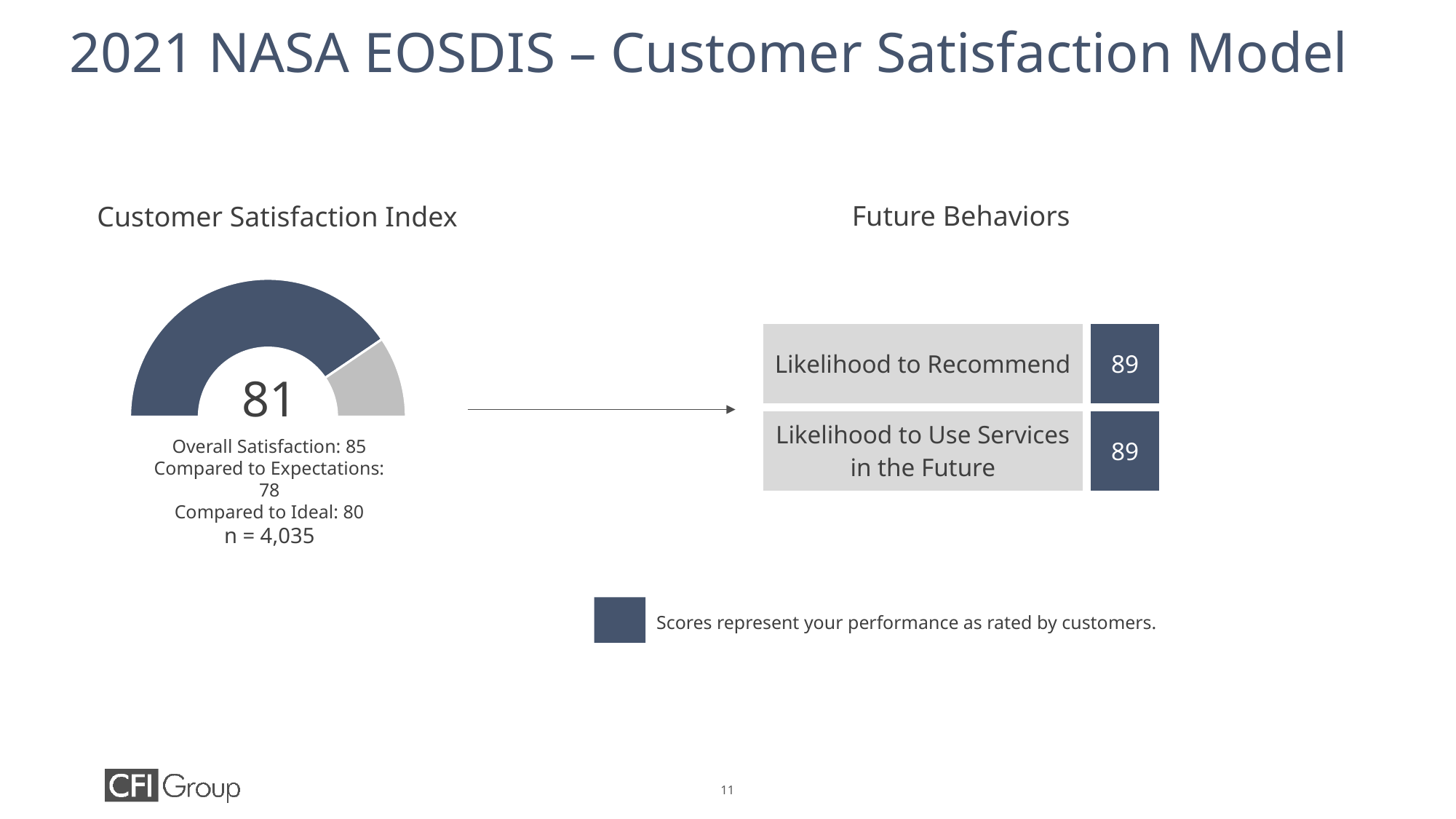
In the Future Behaviors section, what is the score for Likelihood to Recommend? 89 What is the Compared to Ideal score listed under the Customer Satisfaction Index gauge? 80 What kind of chart is used to display the Customer Satisfaction Index? gauge chart What sample size (n) is shown under the Customer Satisfaction Index gauge? 4,035 What is the Overall Satisfaction score listed under the Customer Satisfaction Index gauge? 85 What is the Compared to Expectations score listed under the Customer Satisfaction Index gauge? 78 Which of the three component scores under the Customer Satisfaction Index gauge is the highest? Overall Satisfaction Which of the three component scores under the Customer Satisfaction Index gauge is the lowest? Compared to Expectations What is the difference between the Overall Satisfaction score and the Compared to Expectations score? 7 Which is larger, the Compared to Ideal score or the Compared to Expectations score? Compared to Ideal In the Future Behaviors section, what is the score for Likelihood to Use Services in the Future? 89 What value is displayed in the centre of the Customer Satisfaction Index gauge? 81